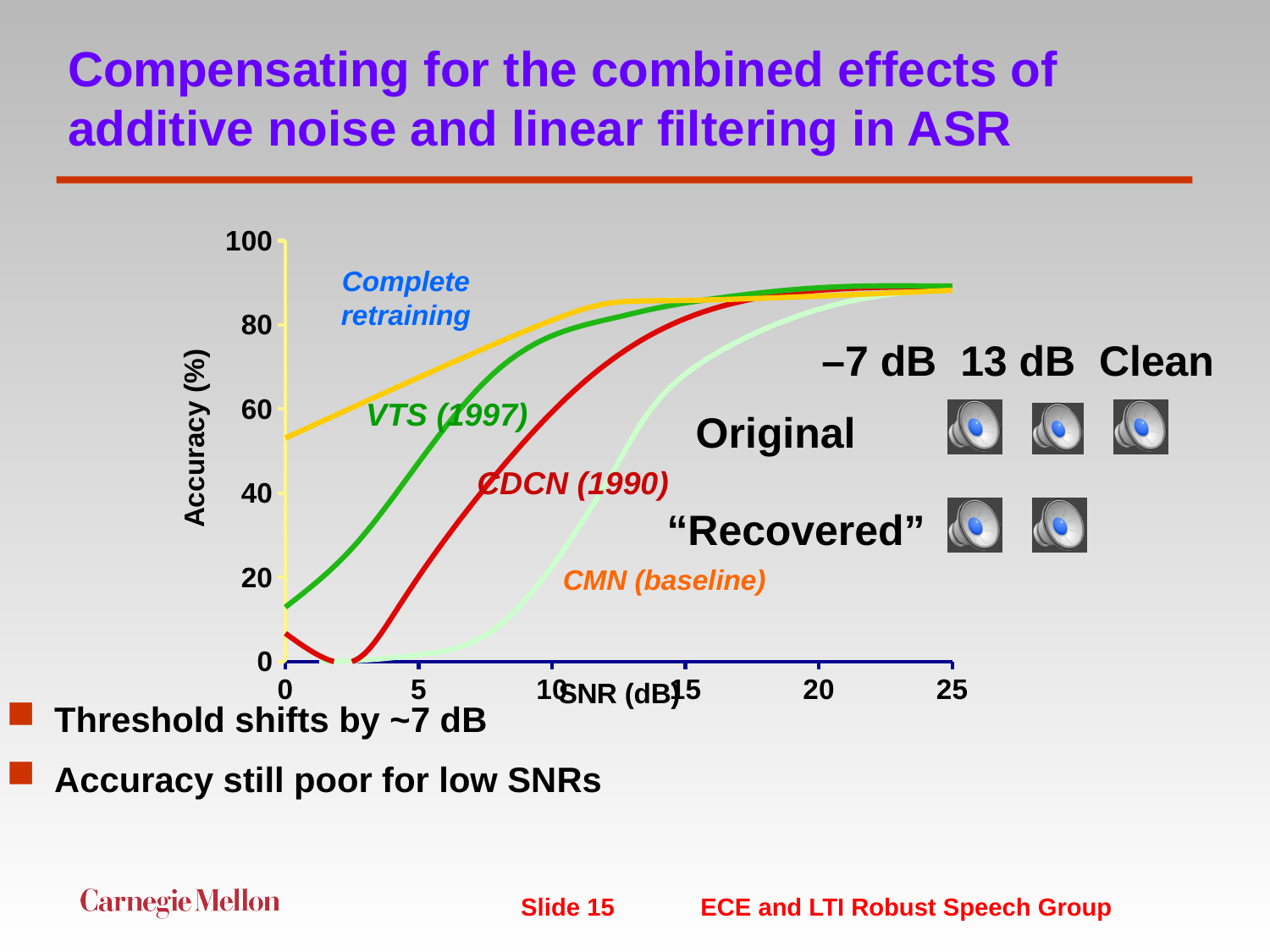
How many labeled curves are plotted on the chart? 4 Is the accuracy of the VTS (1997) curve at 0 dB SNR greater or less than 20? less What is the label of the y axis of the chart? Accuracy (%) What kind of chart is shown on the slide? line chart Is the accuracy of the CDCN (1990) curve at 25 dB SNR greater or less than 80? greater What is the label of the x axis of the chart? SNR (dB) At 10 dB SNR, which curve has higher accuracy: VTS (1997) or CDCN (1990)? VTS (1997) Is the accuracy of the Complete retraining curve at 0 dB SNR greater or less than 40? greater Does accuracy rise or fall as SNR increases along the x axis for the CDCN (1990) curve? rise Which curve has the highest accuracy at 0 dB SNR? Complete retraining At 5 dB SNR, which curve has higher accuracy: Complete retraining or CMN (baseline)? Complete retraining